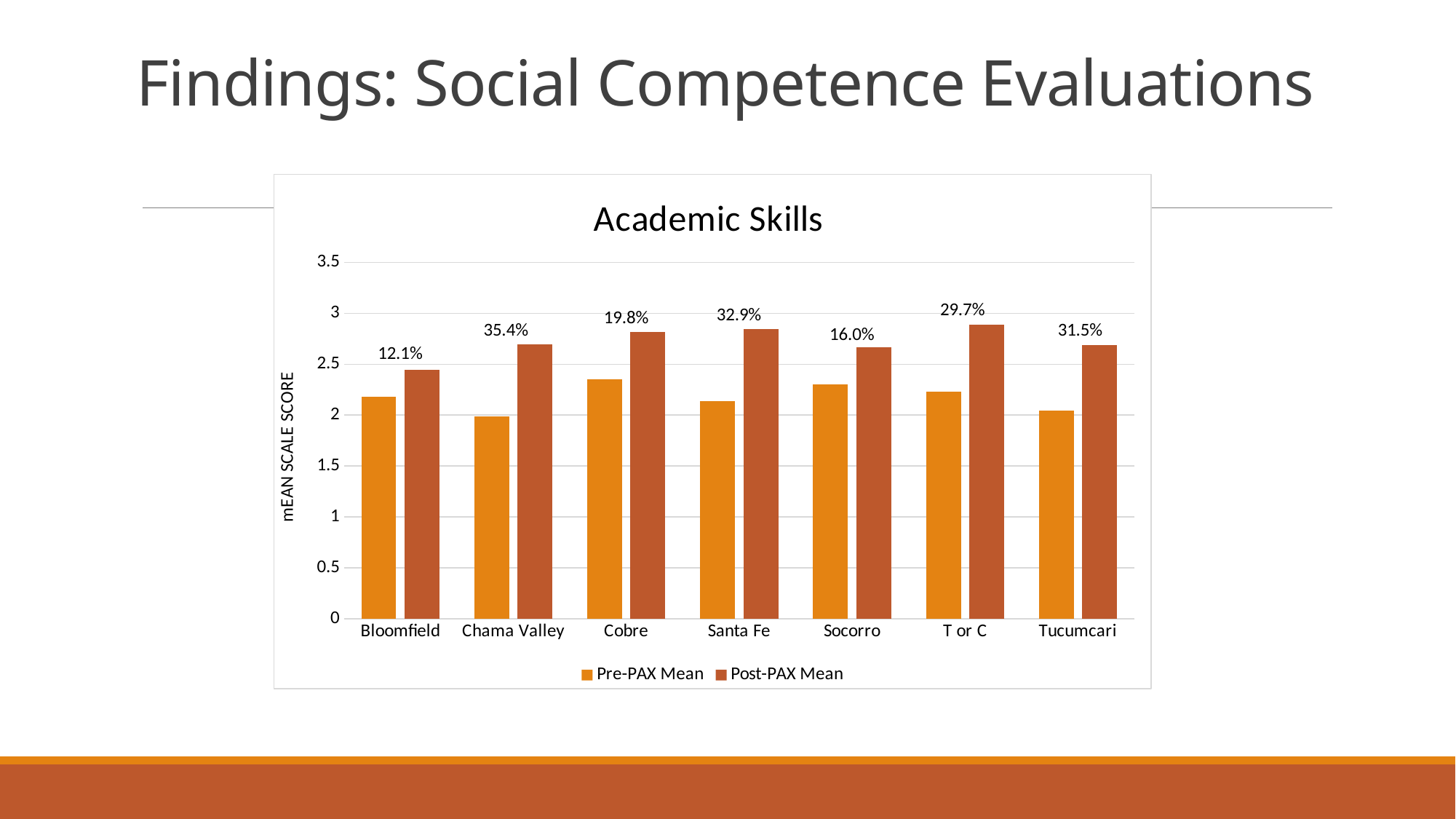
For Socorro, which is larger: the Pre-PAX Mean or the Post-PAX Mean? Post-PAX Mean What percentage label is shown above the Post-PAX Mean bar for Chama Valley? 35.4% What is the title of the chart? Academic Skills Which district has the lowest percentage label shown on the chart? Bloomfield What kind of chart is shown on the slide? bar chart Which district has the highest percentage label shown on the chart? Chama Valley Is the Pre-PAX Mean value for Bloomfield greater or less than 2? greater How many school districts (categories) are shown on the x axis? 7 What percentage label is shown above the Post-PAX Mean bar for Santa Fe? 32.9% What percentage label is shown above the Post-PAX Mean bar for Bloomfield? 12.1% How many series does the legend list? 2 Is the Post-PAX Mean value for Cobre greater or less than 3? less